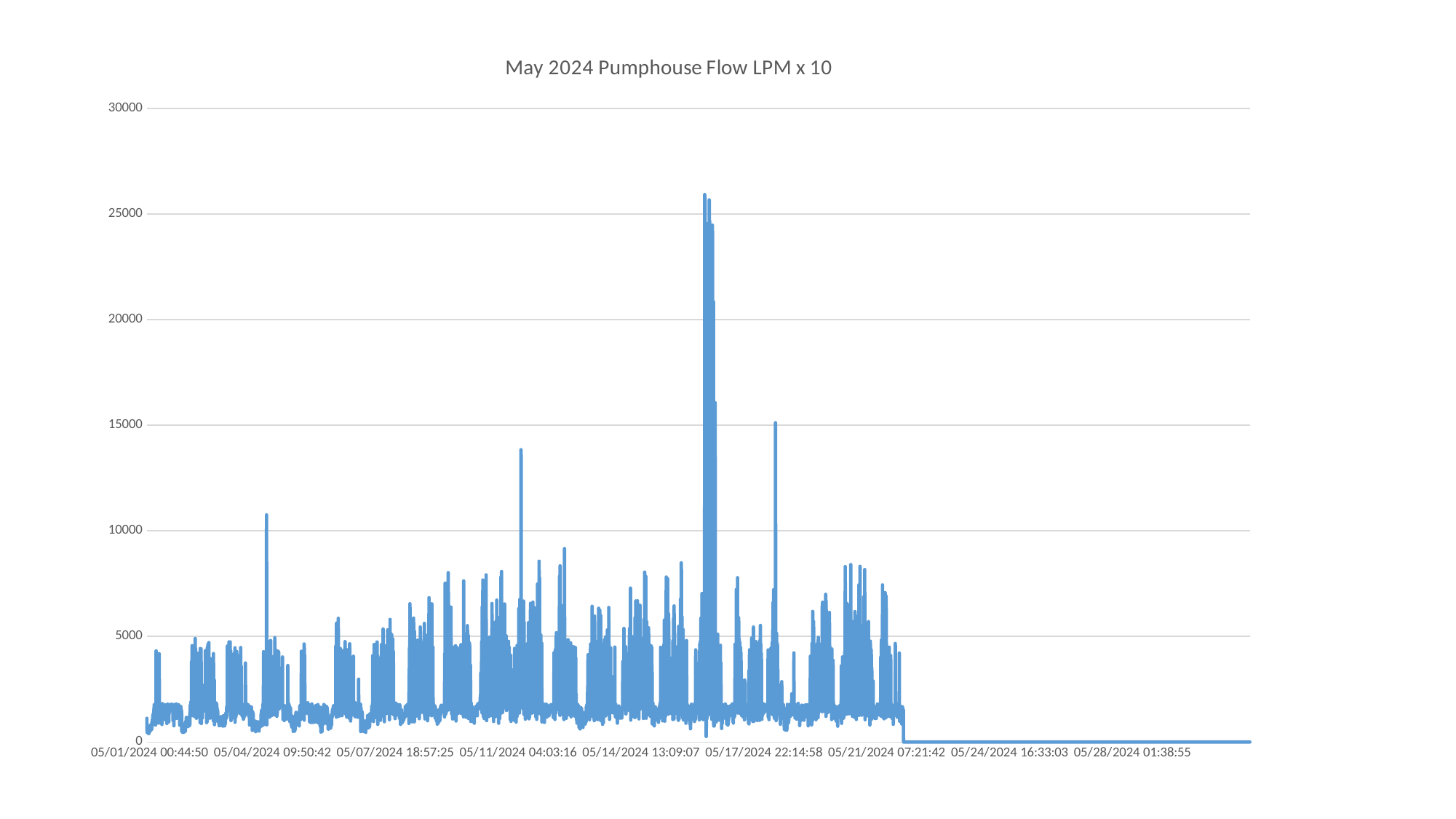
Is the spike near 05/17/2024 larger or smaller than the spike near 05/11/2024? larger Is the spike near 05/11/2024 04:03:16 greater or less than 15000? less Is the spike between 05/17/2024 and 05/21/2024 greater or less than 20000? less Is the spike near 05/04/2024 09:50:42 greater or less than 10000? greater What is the title of the chart? May 2024 Pumphouse Flow LPM x 10 Does the line rise or fall sharply just after 05/21/2024 07:21:42? fall What is the highest value shown on the vertical axis? 30000 What kind of chart is shown on the slide? line chart What is the first label on the horizontal axis? 05/01/2024 00:44:50